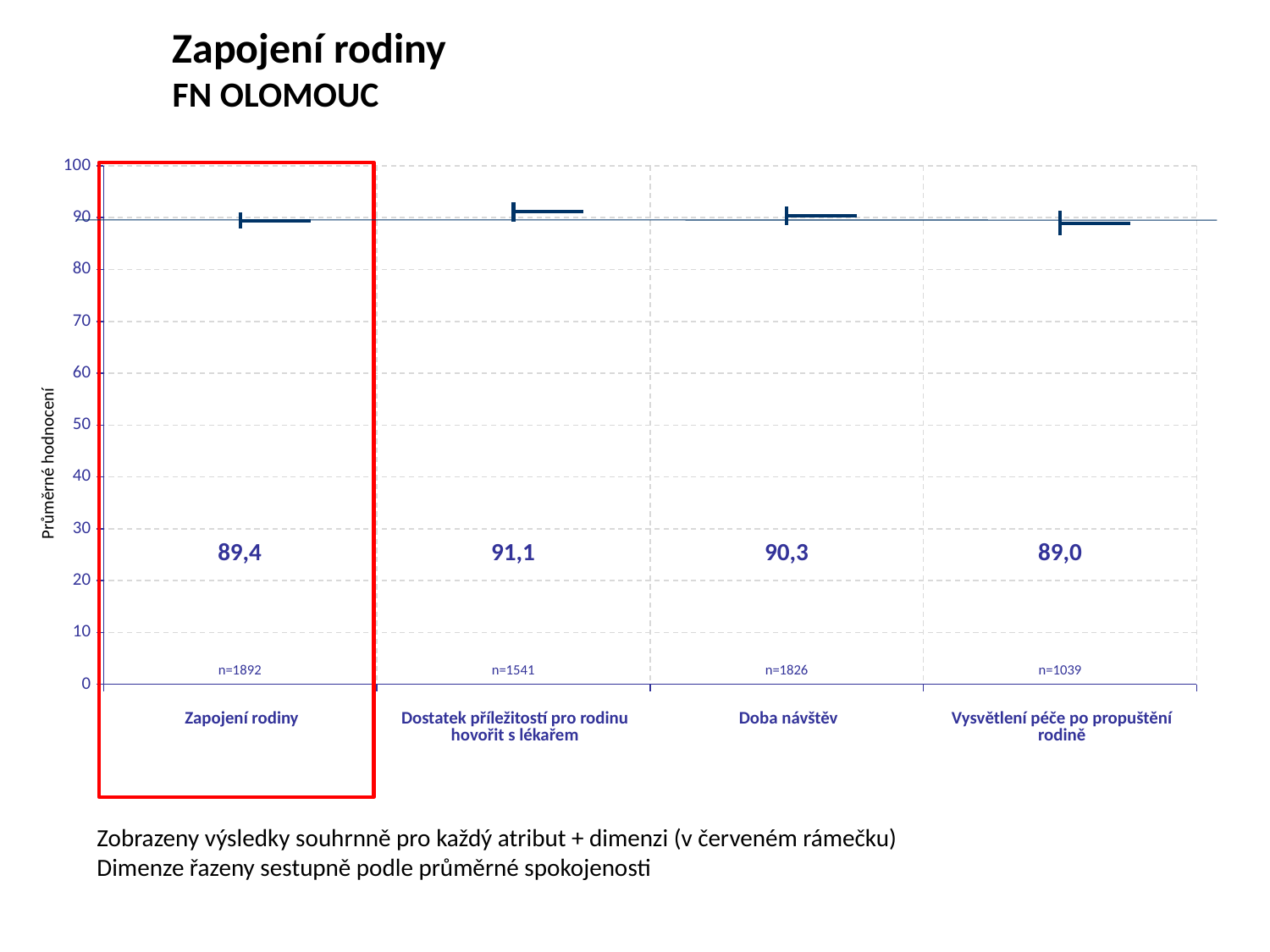
What is the difference between the values for Dostatek příležitostí pro rodinu hovořit s lékařem and Vysvětlení péče po propuštění rodině? 2,1 Which category has the highest value? Dostatek příležitostí pro rodinu hovořit s lékařem Which category is highlighted with a red frame? Zapojení rodiny Which category has the lowest value? Vysvětlení péče po propuštění rodině What is the value for Vysvětlení péče po propuštění rodině? 89,0 What is the value for Dostatek příležitostí pro rodinu hovořit s lékařem? 91,1 Which is larger, the value for Doba návštěv or the value for Zapojení rodiny? Doba návštěv What is the n (number of respondents) shown for Doba návštěv? n=1826 What is the value for Doba návštěv? 90,3 What is the value for Zapojení rodiny? 89,4 How many categories are shown on the x axis? 4 What is the label of the y axis? Průměrné hodnocení